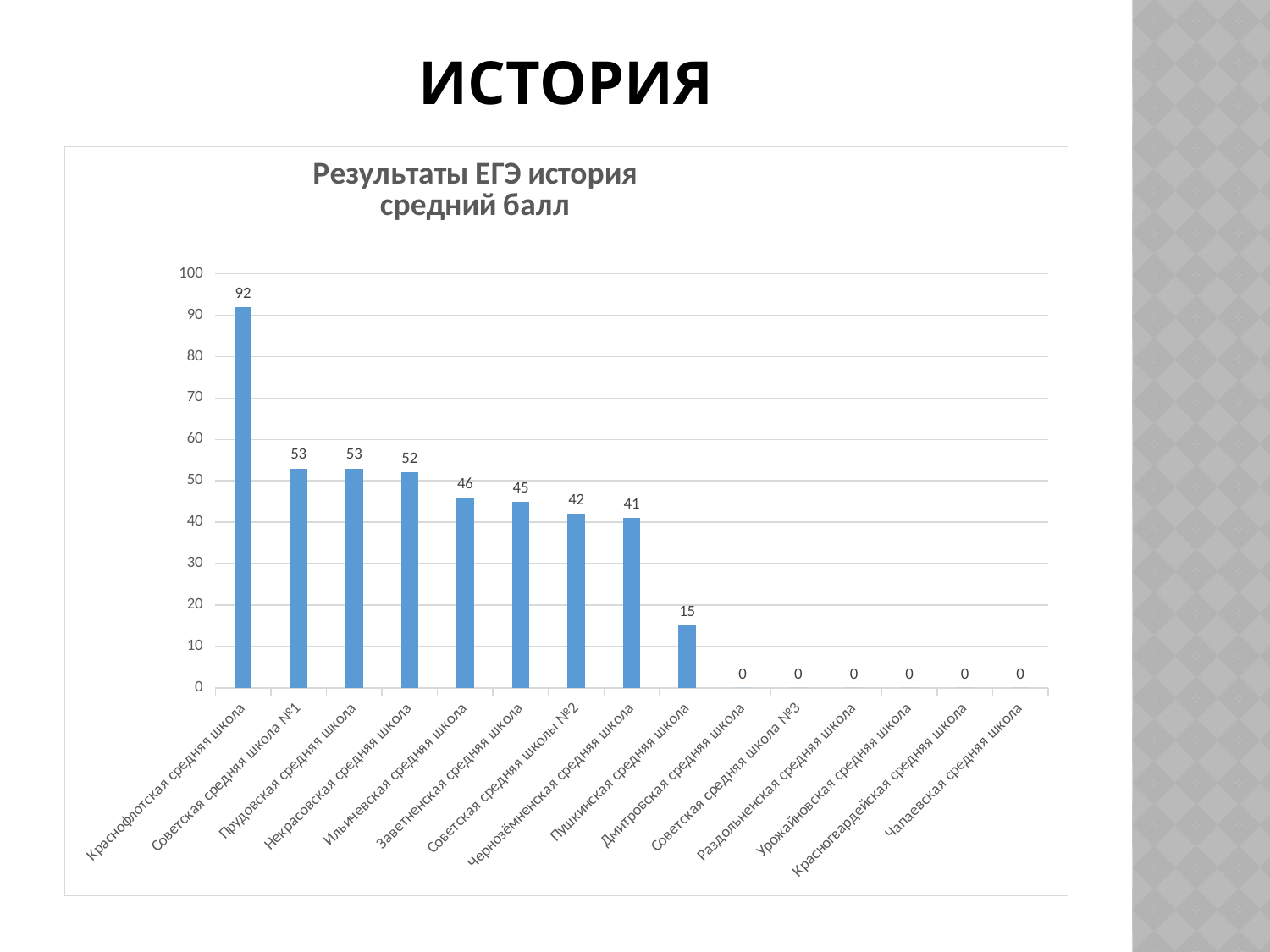
What is the title of the chart? Результаты ЕГЭ история средний балл What is the average score for Пушкинская средняя школа? 15 Which school has the highest average score? Краснофлотская средняя школа What is the difference between the scores of Ильичевская средняя школа and Заветненская средняя школа? 1 What is the average score for Чернозёмненская средняя школа? 41 Which has a higher score, Советская средняя школы №2 or Пушкинская средняя школа? Советская средняя школы №2 What is the difference between the scores of Краснофлотская средняя школа and Советская средняя школа №1? 39 What type of chart is shown on the slide? Bar chart What is the average score for Некрасовская средняя школа? 52 How many schools have a score of 0? 6 What is the average score for Краснофлотская средняя школа? 92 How many schools are shown on the chart? 15